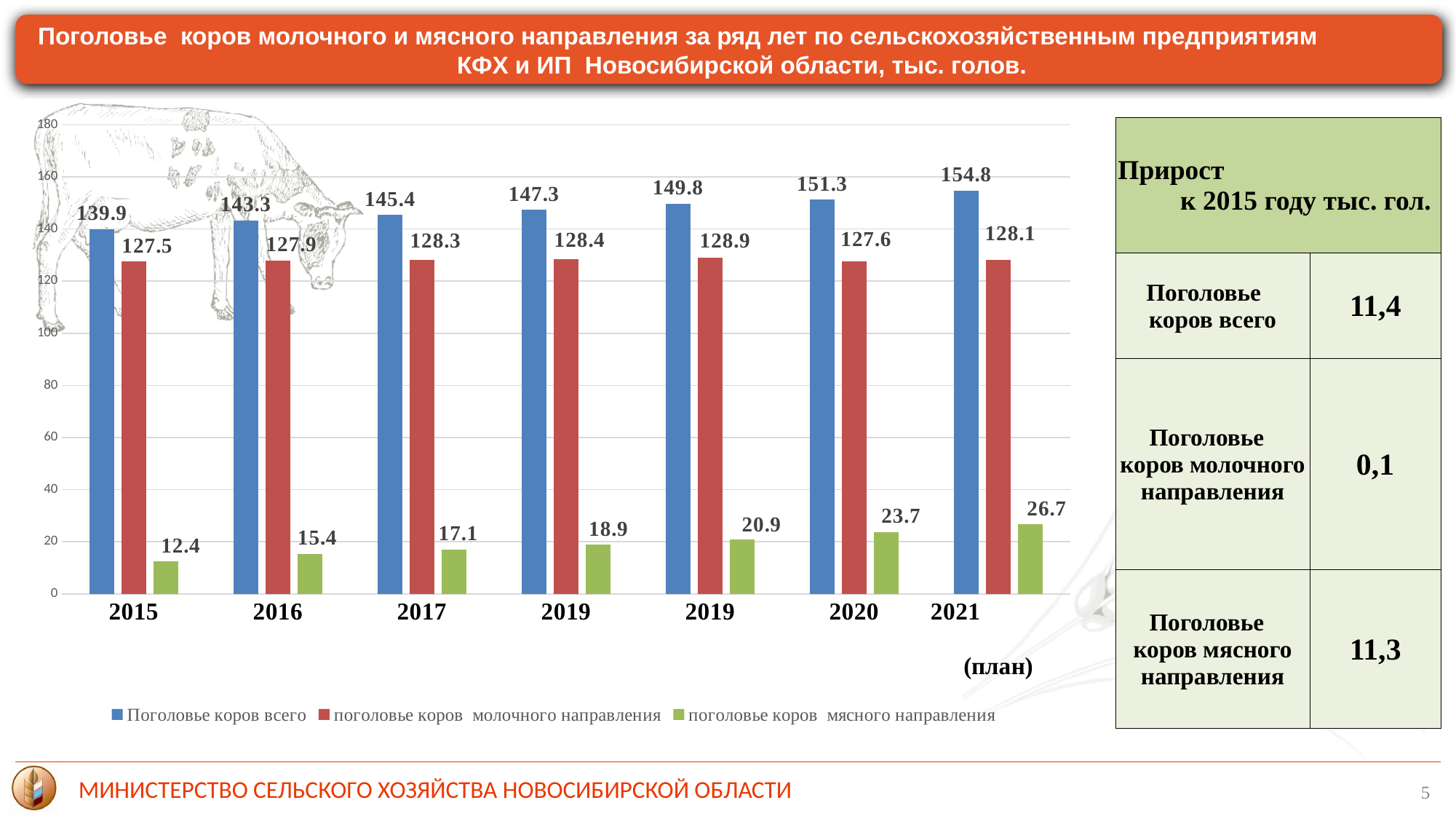
In which year is "поголовье коров мясного направления" the lowest? 2015 How many year categories are shown on the x axis of the chart? 7 What is the difference between "Поголовье коров всего" in 2021 (план) and in 2015? 14.9 In which year is "Поголовье коров всего" the highest? 2021 (план) What is the value of "Поголовье коров всего" for 2015? 139.9 What kind of chart is shown on the slide? bar chart Is the value of "Поголовье коров всего" for 2017 greater or less than 140? greater How many series does the chart legend list? 3 Which is larger: "поголовье коров мясного направления" in 2020 or in 2016? 2020 What is the value of "поголовье коров молочного направления" for 2020? 127.6 Does "поголовье коров мясного направления" rise or fall from 2015 to 2021 (план)? rise What is the value of "поголовье коров мясного направления" for 2021 (план)? 26.7